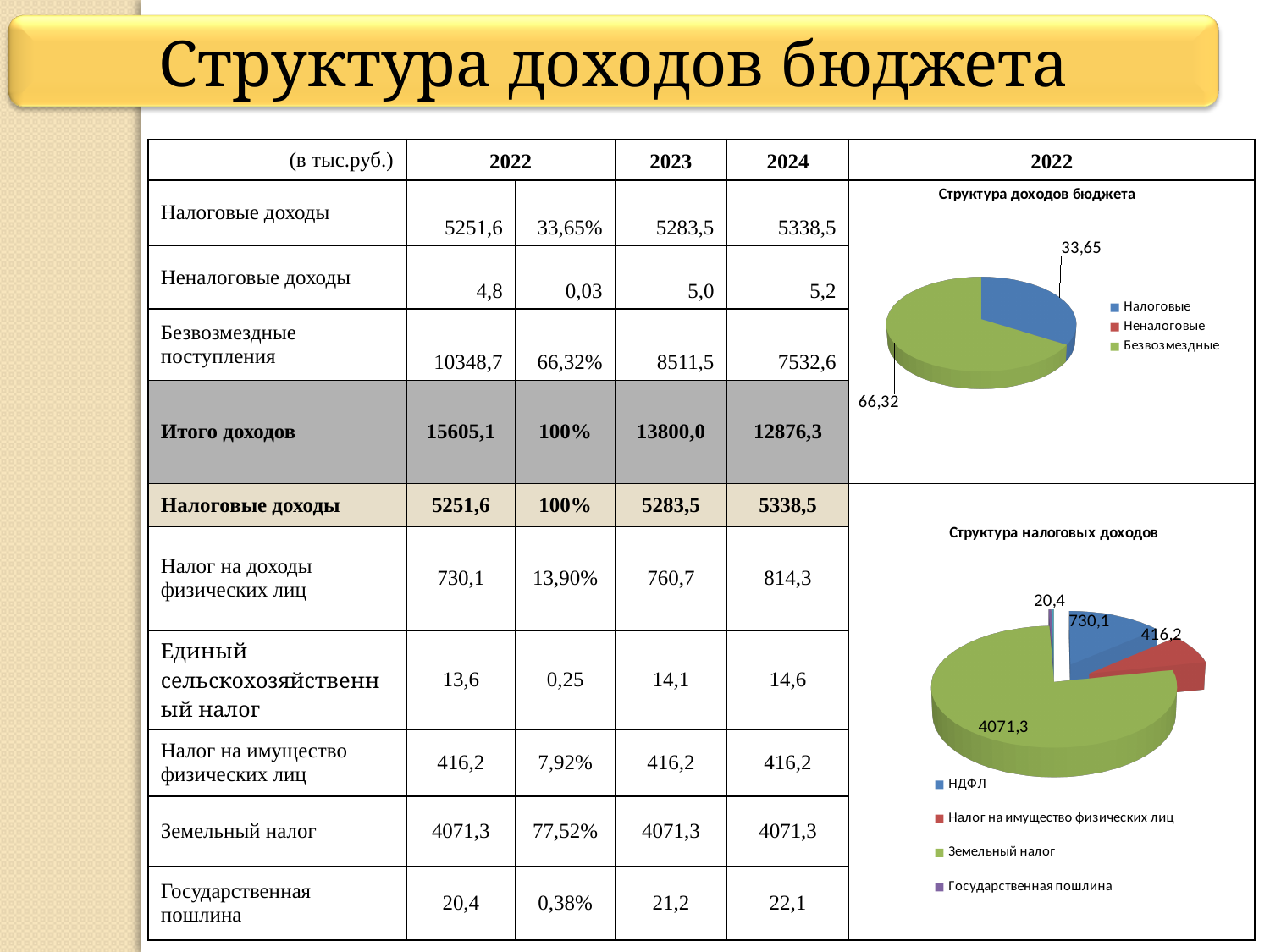
In the chart titled "Структура налоговых доходов", what value is shown for Государственная пошлина? 20,4 In the chart titled "Структура налоговых доходов", which is larger: НДФЛ or Налог на имущество физических лиц? НДФЛ In the chart titled "Структура доходов бюджета", which category has the largest slice? Безвозмездные In the chart titled "Структура налоговых доходов", what is the difference between the НДФЛ value and the Налог на имущество физических лиц value? 313,9 In the chart titled "Структура доходов бюджета", what value is shown for the Безвозмездные slice? 66,32 In the chart titled "Структура доходов бюджета", how many entries does the legend list? 3 What kind of chart is the chart titled "Структура доходов бюджета"? Pie chart In the chart titled "Структура доходов бюджета", what value is shown for the Налоговые slice? 33,65 In the chart titled "Структура налоговых доходов", what value is shown for НДФЛ? 730,1 In the chart titled "Структура налоговых доходов", what value is shown for Земельный налог? 4071,3 In the chart titled "Структура налоговых доходов", how many categories does the legend list? 4